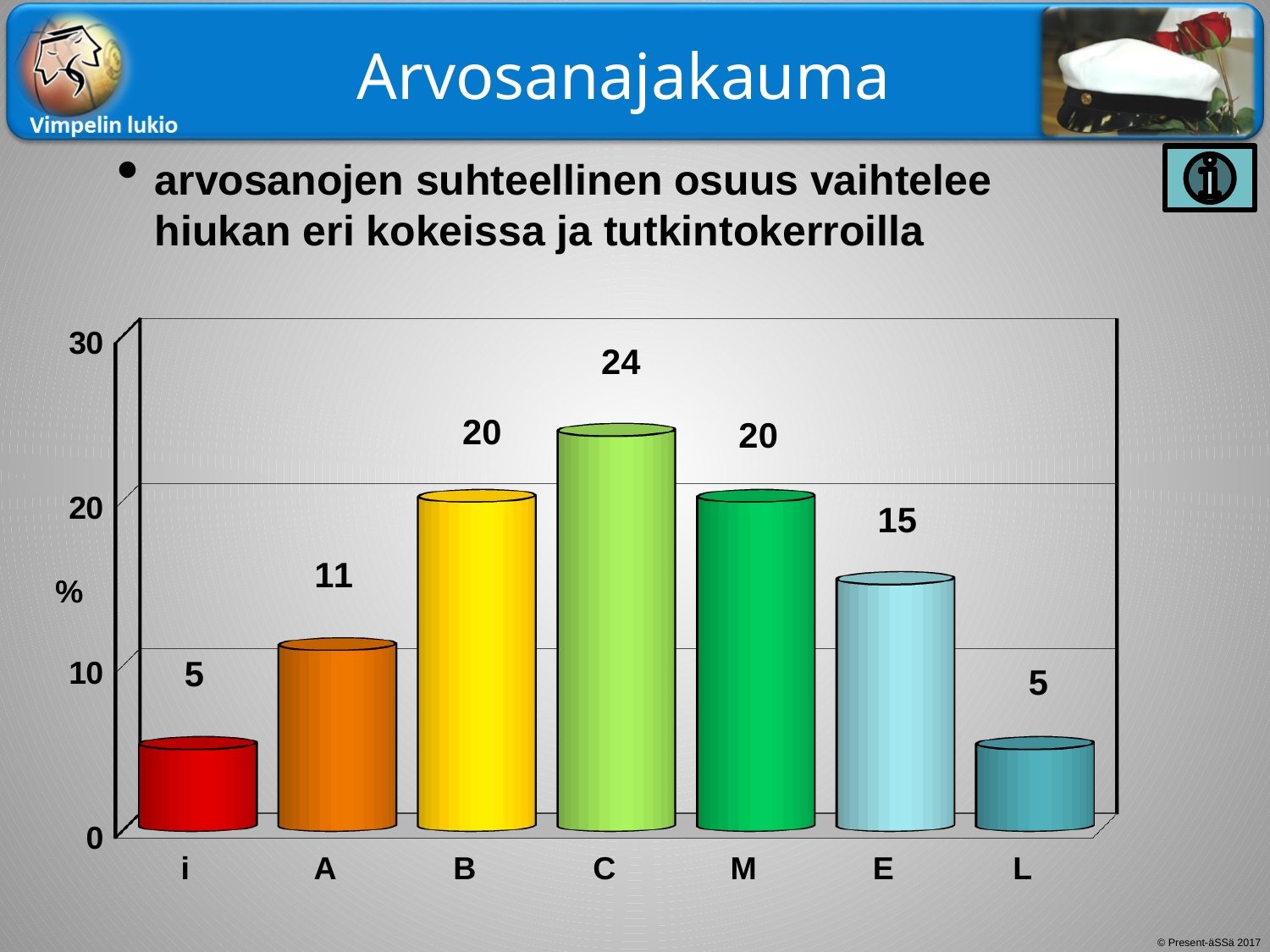
What is the difference between the values for B and A? 9 How many grade categories are shown on the x axis? 7 What kind of chart is shown on the slide? bar chart Is the value for M greater or less than 10? greater Do the values rise or fall from C to L along the x axis? fall What is the value for grade C? 24 What is the value for grade E? 15 Which grade has the highest value? C What unit is shown on the y axis label? % Which is larger, the value for A or the value for E? E What is the difference between the values for C and E? 9 What is the value for grade A? 11